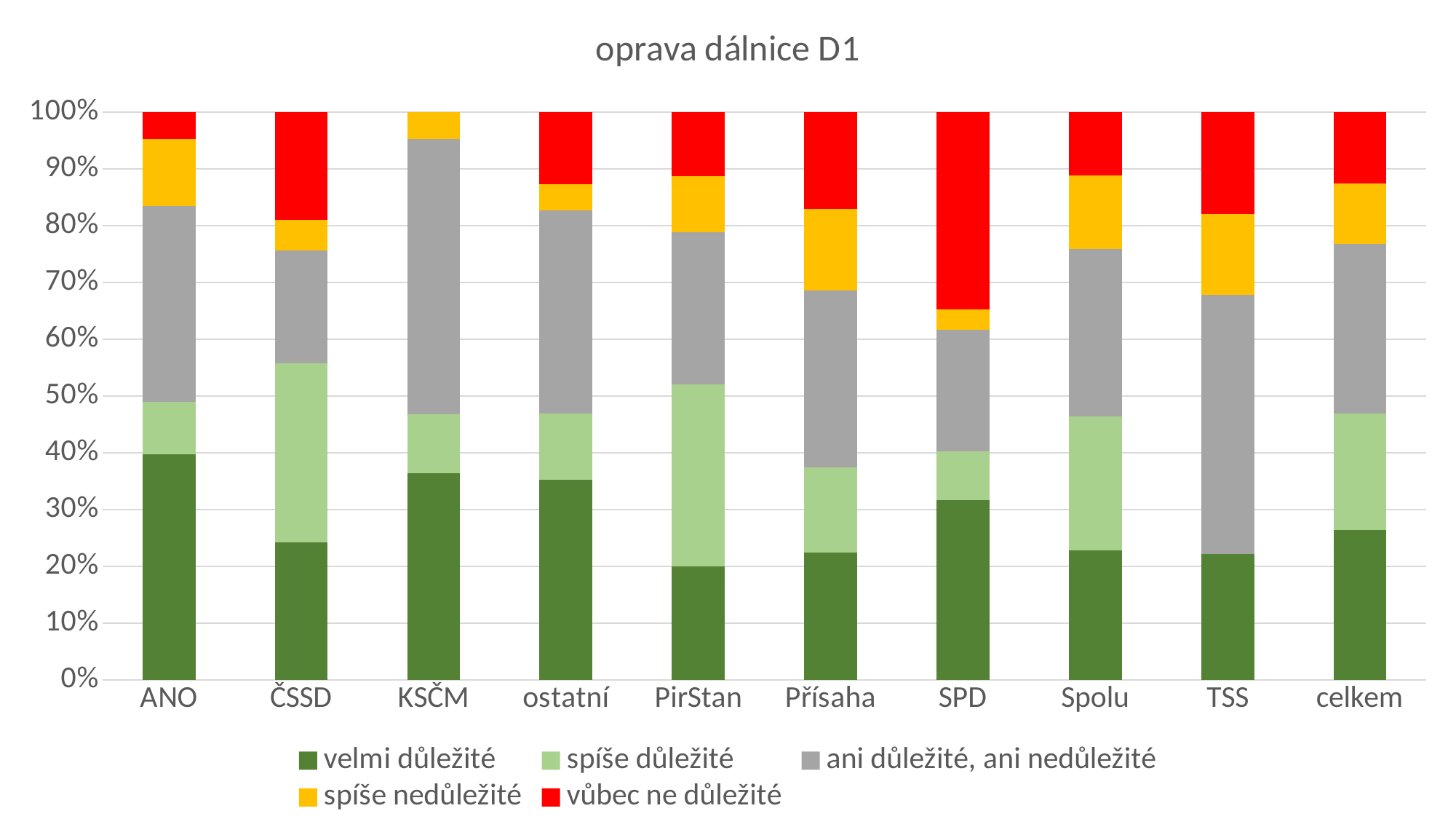
Which has a larger 'spíše důležité' segment, ANO or ČSSD? ČSSD Is the 'velmi důležité' value for PirStan greater or less than 30%? less Which category has the largest 'vůbec ne důležité' segment? SPD What is the title of the chart? oprava dálnice D1 How many series does the legend list? 5 Which has a larger 'vůbec ne důležité' segment, SPD or ANO? SPD What type of chart is shown on the slide? stacked bar chart Is the 'velmi důležité' value for ANO greater or less than 30%? greater Is the 'velmi důležité' value for ČSSD greater or less than 30%? less How many categories are shown on the x axis? 10 Which category has no 'vůbec ne důležité' segment at all? KSČM Which category has the largest 'velmi důležité' segment? ANO